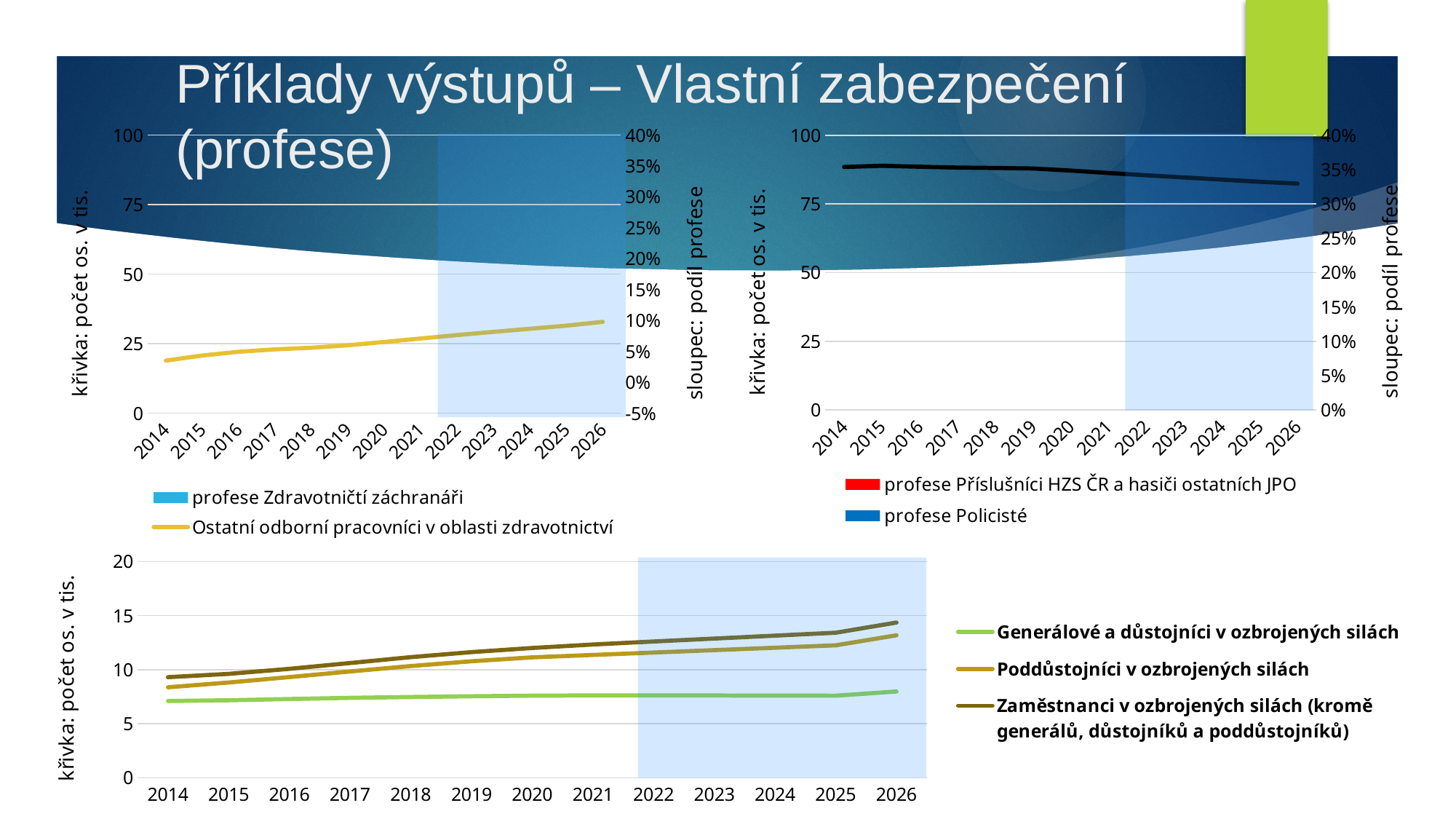
In the top-left chart, is the 2014 value for Ostatní odborní pracovníci v oblasti zdravotnictví greater or less than 25? less In the bottom chart, is the 2014 value for Generálové a důstojníci v ozbrojených silách greater or less than 10? less In the bottom chart, which is larger in 2026: Poddůstojníci v ozbrojených silách or Generálové a důstojníci v ozbrojených silách? Poddůstojníci v ozbrojených silách In the top-right chart, is the 2014 value of the plotted line greater or less than 75? greater How many series does the legend of the top-right chart list? 2 In the bottom chart, which series has the lowest values across all years? Generálové a důstojníci v ozbrojených silách What kind of chart is the bottom chart on the slide? line chart In the bottom chart, which series has the highest values across all years? Zaměstnanci v ozbrojených silách (kromě generálů, důstojníků a poddůstojníků) In the top-left chart, do the values for Ostatní odborní pracovníci v oblasti zdravotnictví rise or fall from 2014 to 2026? rise How many series does the legend of the bottom chart list? 3 How many years are shown on the x axis of the bottom chart? 13